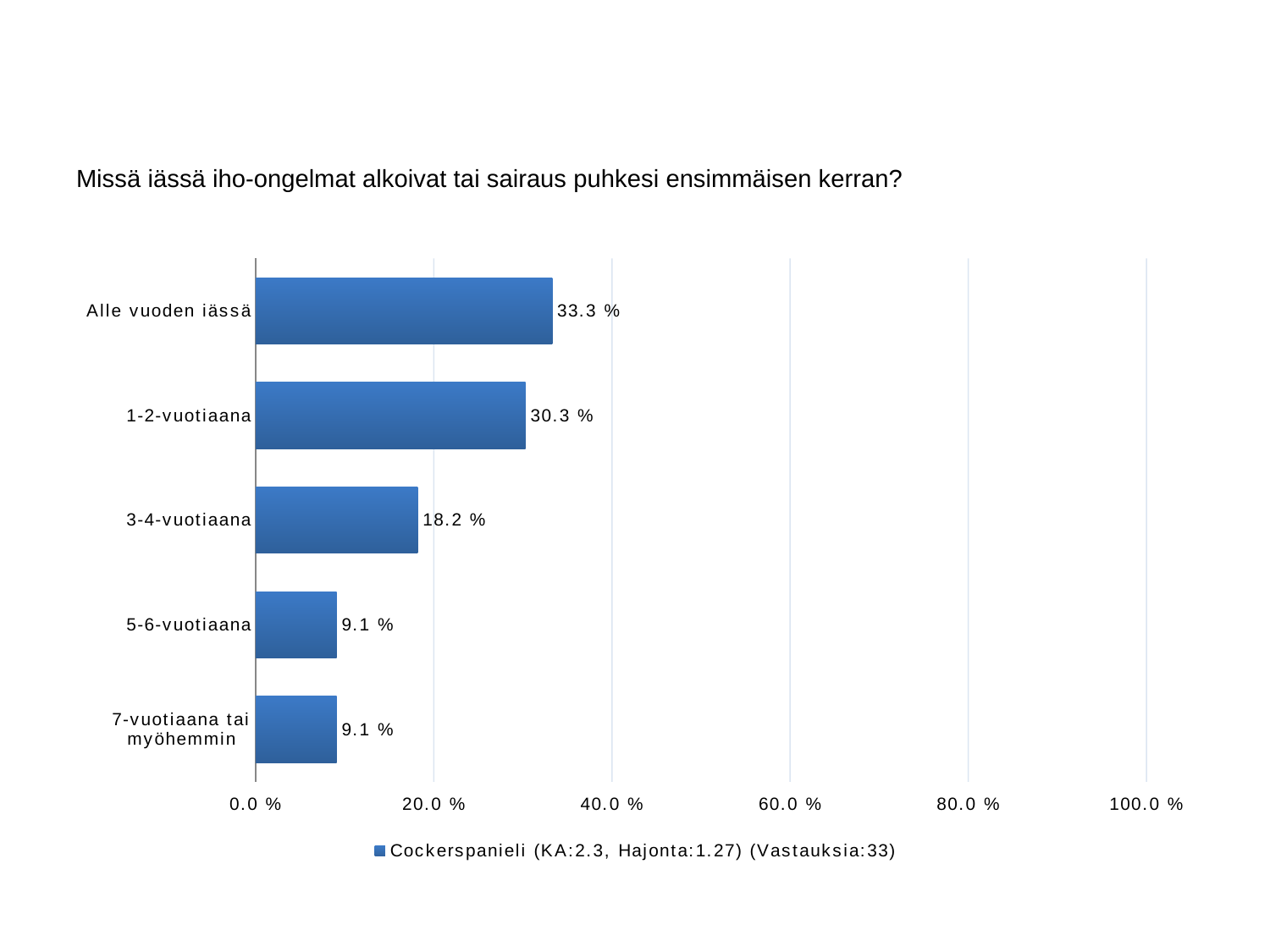
What kind of chart is shown on the slide? bar chart Is the value for "Alle vuoden iässä" greater or less than 40.0 %? less What is the difference between the values for "1-2-vuotiaana" and "3-4-vuotiaana"? 12.1 % What is the value for "1-2-vuotiaana"? 30.3 % How many series does the legend list? 1 How many categories are shown in the chart? 5 What is the value for "Alle vuoden iässä"? 33.3 % What is the value for "3-4-vuotiaana"? 18.2 % What is the title of the chart? Missä iässä iho-ongelmat alkoivat tai sairaus puhkesi ensimmäisen kerran? Which category has the highest value? Alle vuoden iässä What is the difference between the values for "Alle vuoden iässä" and "1-2-vuotiaana"? 3.0 % Which is larger, the value for "3-4-vuotiaana" or the value for "5-6-vuotiaana"? 3-4-vuotiaana